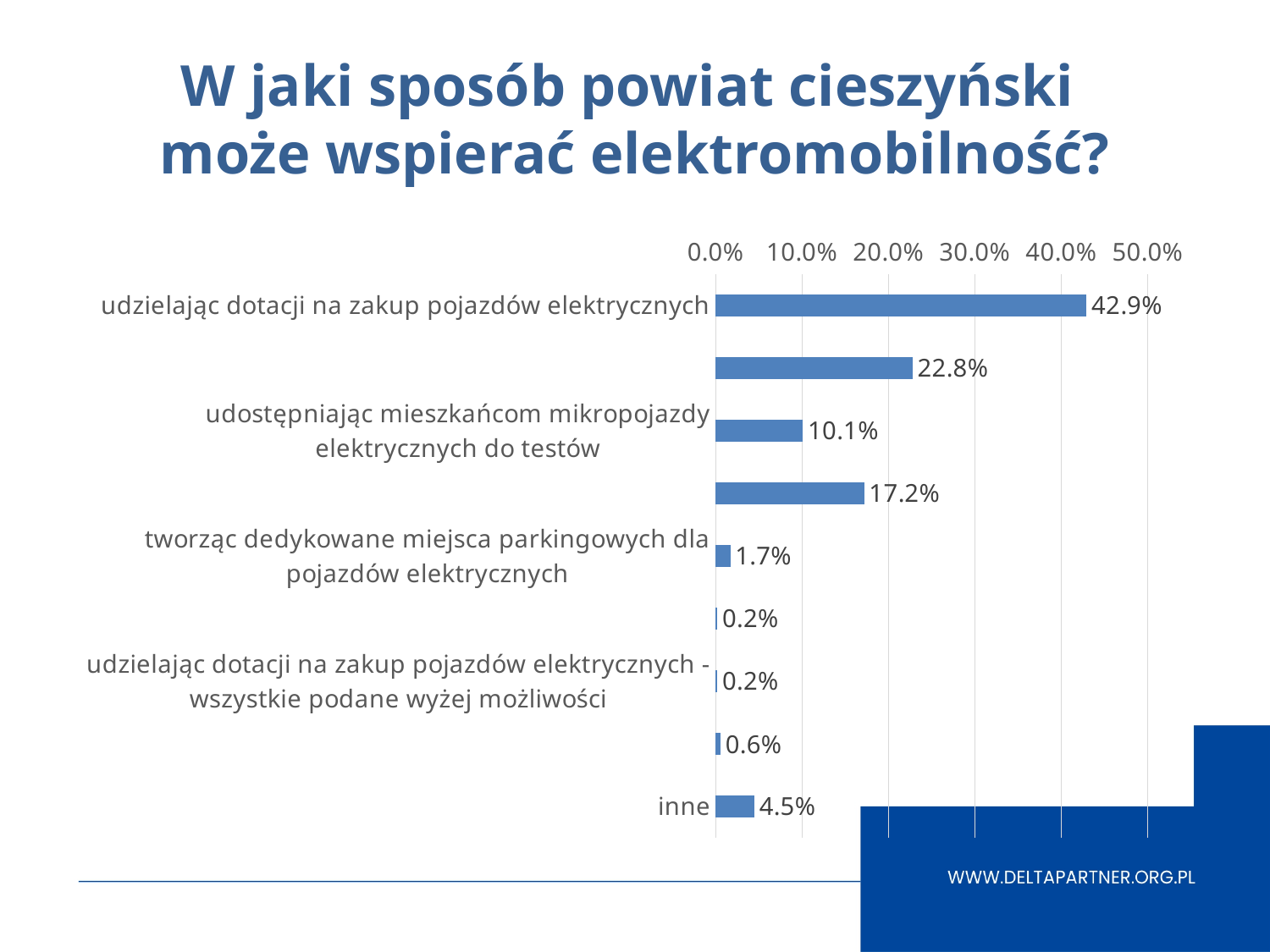
What is the difference between the values for "inne" and "tworząc dedykowane miejsca parkingowych dla pojazdów elektrycznych"? 2.8% What is the value for "udzielając dotacji na zakup pojazdów elektrycznych - wszystkie podane wyżej możliwości"? 0.2% What is the value for "udzielając dotacji na zakup pojazdów elektrycznych"? 42.9% How many bars are plotted in the chart? 9 What kind of chart is shown on the slide? bar chart What is the value for "udostępniając mieszkańcom mikropojazdy elektrycznych do testów"? 10.1% Which category has the highest value? udzielając dotacji na zakup pojazdów elektrycznych What is the value for "inne"? 4.5% What is the value for "tworząc dedykowane miejsca parkingowych dla pojazdów elektrycznych"? 1.7% Is the value for "udzielając dotacji na zakup pojazdów elektrycznych" greater or less than 40.0%? greater Which is larger: the value for "inne" or the value for "tworząc dedykowane miejsca parkingowych dla pojazdów elektrycznych"? inne What is the difference between the values for "udzielając dotacji na zakup pojazdów elektrycznych" and "udostępniając mieszkańcom mikropojazdy elektrycznych do testów"? 32.8%